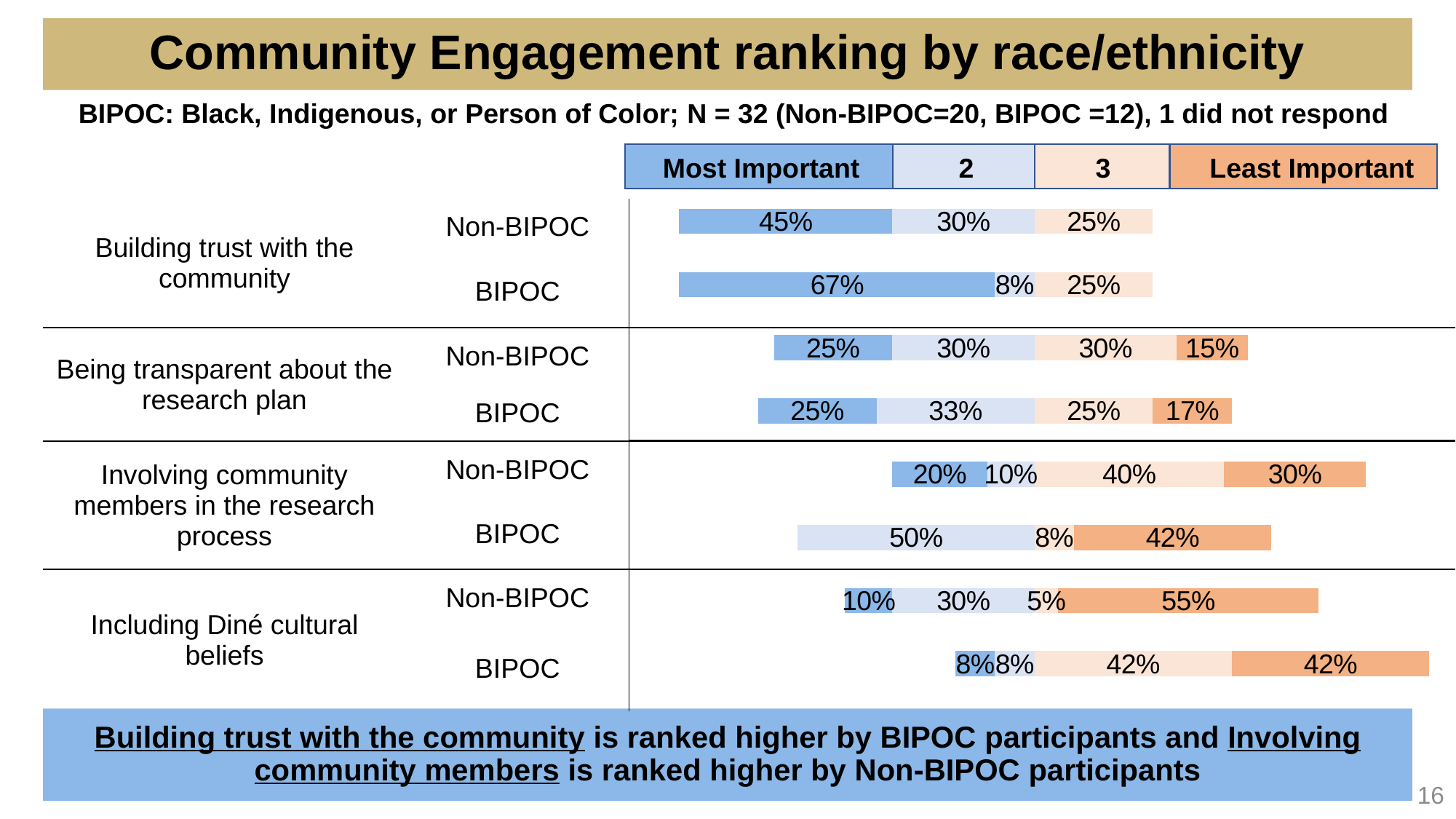
What type of chart is used on this slide? Stacked bar chart What percentage of BIPOC participants gave 'Involving community members in the research process' a rank of 2? 50% Which group has the larger Most Important share for 'Building trust with the community', Non-BIPOC or BIPOC? BIPOC What is the difference between the BIPOC and Non-BIPOC Most Important shares for 'Building trust with the community'? 22% Which group has the larger Least Important share for 'Involving community members in the research process', Non-BIPOC or BIPOC? BIPOC What percentage of Non-BIPOC participants ranked 'Being transparent about the research plan' as Least Important? 15% Which legend entry is shown in the darkest orange colour? Least Important How many ranking levels does the legend list? 4 How many community engagement items are shown in the chart? 4 Among the Non-BIPOC rows, which community engagement item has the highest Most Important share? Building trust with the community What percentage of Non-BIPOC participants ranked 'Including Diné cultural beliefs' as Least Important? 55% What percentage of BIPOC participants ranked 'Building trust with the community' as Most Important? 67%